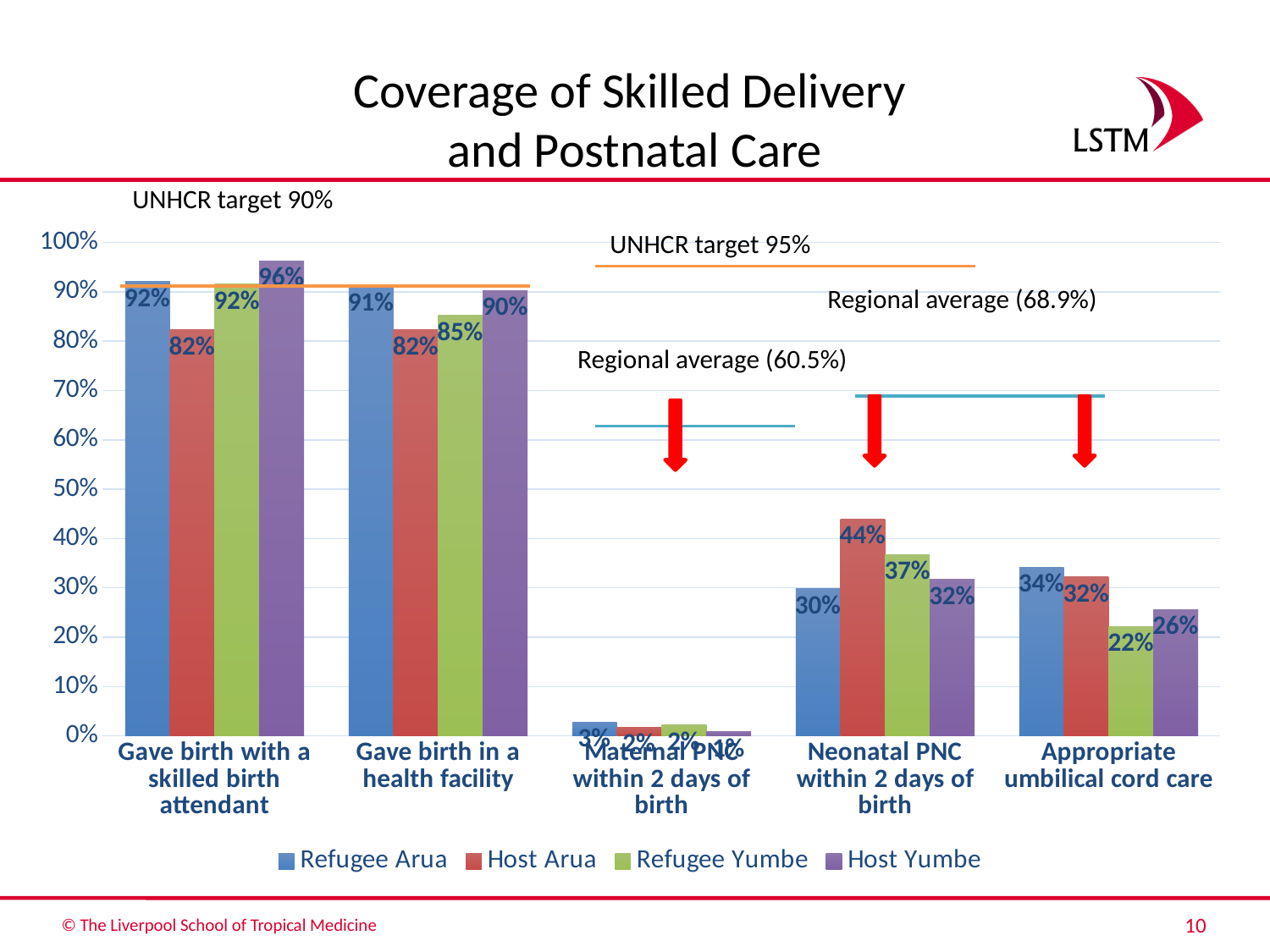
Which is larger for 'Appropriate umbilical cord care': Refugee Arua or Host Yumbe? Refugee Arua How many categories are shown on the x axis? 5 How many series does the legend list? 4 What kind of chart is shown on the slide? Bar chart What is the difference between Refugee Arua and Host Arua for 'Gave birth with a skilled birth attendant'? 10% What is the value for Refugee Yumbe for 'Appropriate umbilical cord care'? 22% What is the value for Host Arua for 'Neonatal PNC within 2 days of birth'? 44% What is the title of the slide's chart? Coverage of Skilled Delivery and Postnatal Care Is the value for Refugee Yumbe for 'Gave birth in a health facility' greater or less than 80%? greater Which series has the highest value for 'Neonatal PNC within 2 days of birth'? Host Arua Which series has the lowest value for 'Gave birth in a health facility'? Host Arua What is the value for Host Yumbe for 'Gave birth with a skilled birth attendant'? 96%